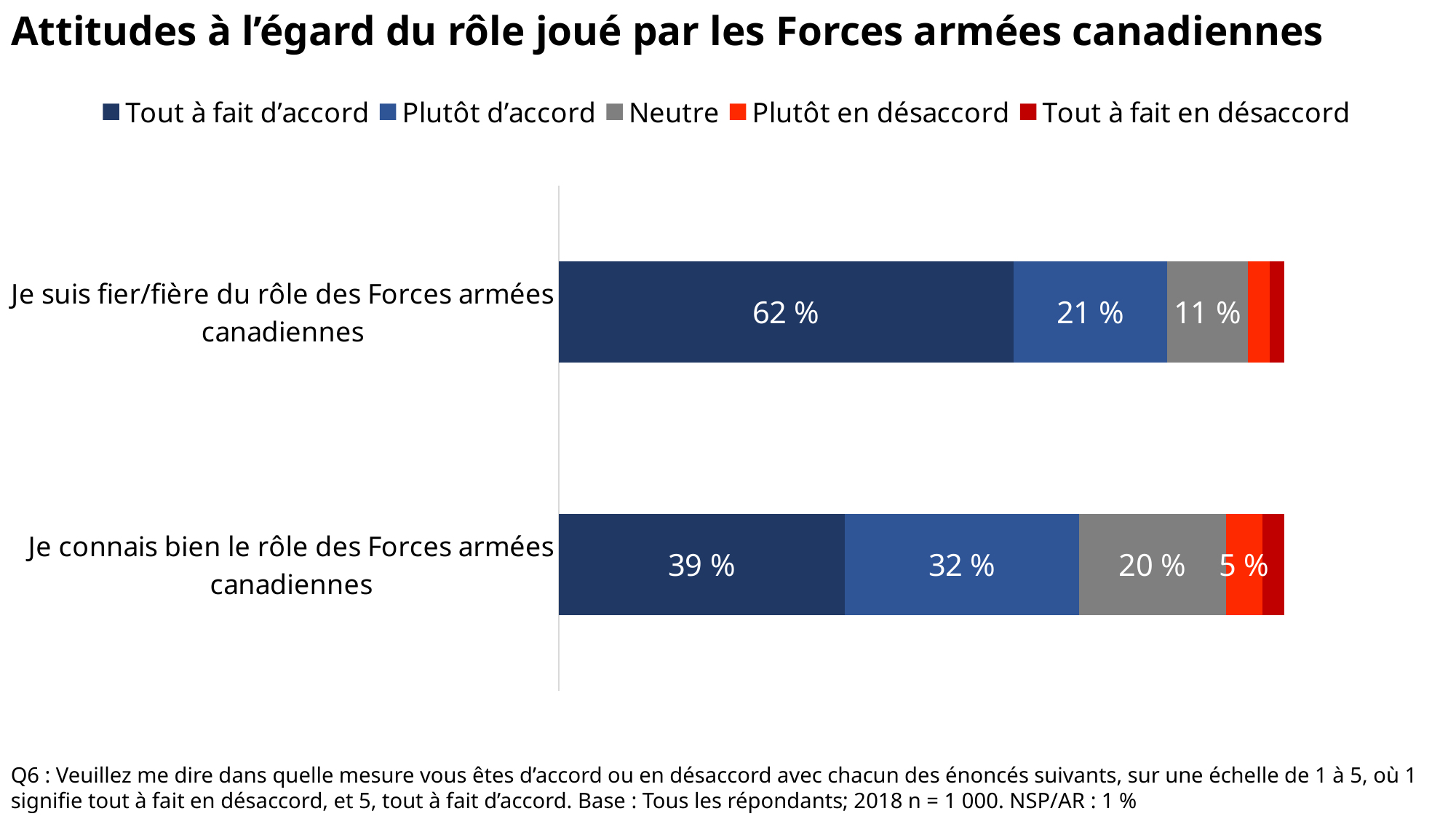
What percentage of respondents are 'Tout à fait d'accord' with 'Je suis fier/fière du rôle des Forces armées canadiennes'? 62 % What is the 'Plutôt en désaccord' value for 'Je connais bien le rôle des Forces armées canadiennes'? 5 % What is the 'Neutre' value for 'Je suis fier/fière du rôle des Forces armées canadiennes'? 11 % Which statement has the higher 'Tout à fait d'accord' share? Je suis fier/fière du rôle des Forces armées canadiennes Is the 'Plutôt d'accord' value larger for 'Je suis fier/fière du rôle des Forces armées canadiennes' or for 'Je connais bien le rôle des Forces armées canadiennes'? Je connais bien le rôle des Forces armées canadiennes What type of chart is shown on the slide? stacked bar chart How many series does the legend list? 5 What is the difference between the 'Tout à fait d'accord' values of the two statements? 23 % What colour represents 'Neutre' in the legend? grey How many statements (categories) are plotted in the chart? 2 Which statement has the lower 'Neutre' share? Je suis fier/fière du rôle des Forces armées canadiennes What is the 'Plutôt d'accord' value for 'Je connais bien le rôle des Forces armées canadiennes'? 32 %